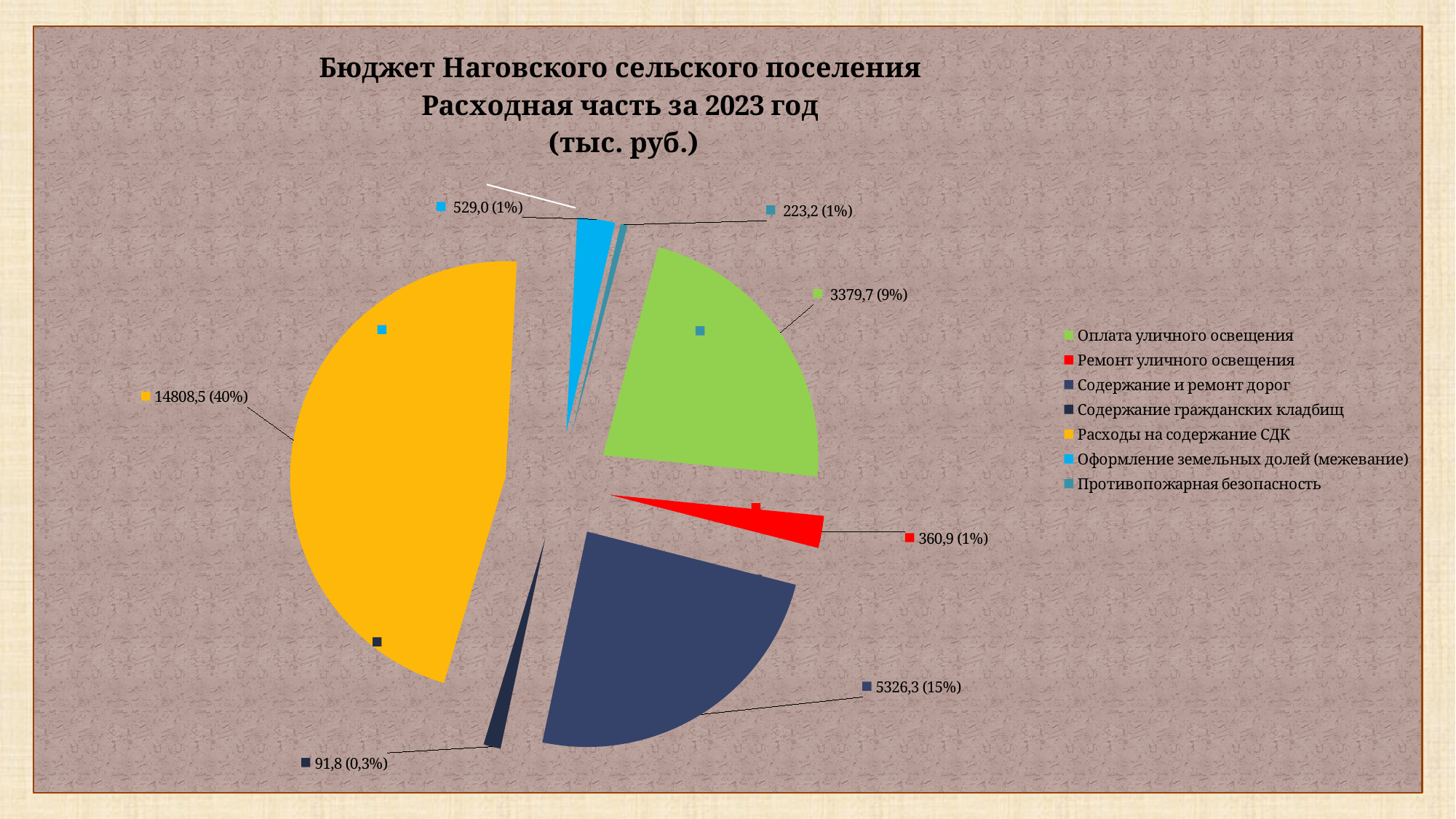
What is the value for Оплата уличного освещения? 3379,7 What share of the pie does Содержание и ремонт дорог represent, as printed on the slide? 15% What kind of chart is shown on the slide? pie chart Which is larger: the value for Содержание и ремонт дорог or the value for Оплата уличного освещения? Содержание и ремонт дорог What is the value for Расходы на содержание СДК? 14808,5 Which category has the largest value? Расходы на содержание СДК What is the difference between the values for Оформление земельных долей (межевание) and Ремонт уличного освещения? 168,1 What is the difference between the values for Расходы на содержание СДК and Содержание и ремонт дорог? 9482,2 How many categories does the legend list? 7 What is the value for Содержание и ремонт дорог? 5326,3 Which category has the smallest value? Содержание гражданских кладбищ What is the value for Противопожарная безопасность? 223,2